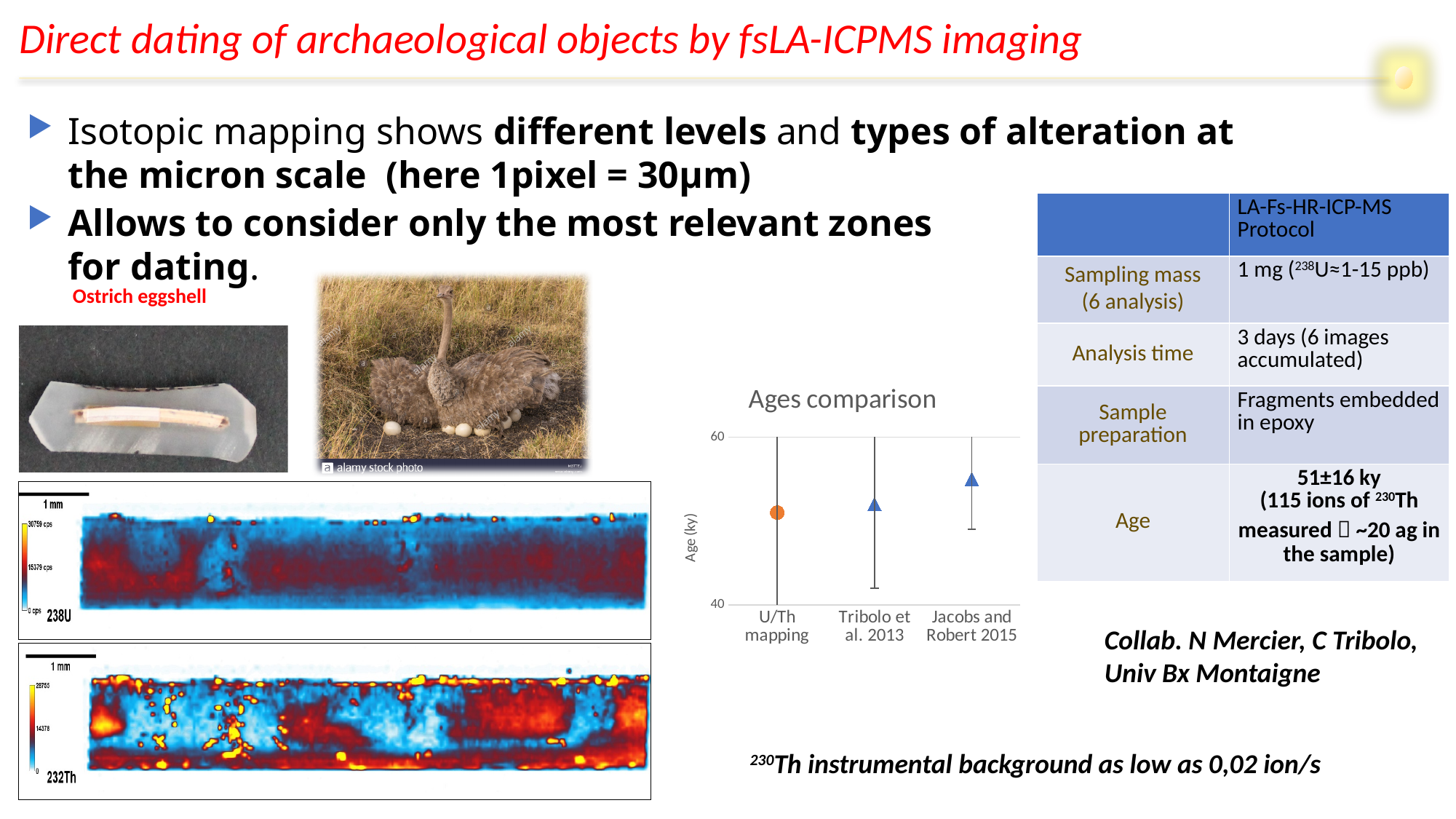
In the Ages comparison chart, which category has the highest plotted age? Jacobs and Robert 2015 In the Ages comparison chart, which is larger: the plotted age for Jacobs and Robert 2015 or for U/Th mapping? Jacobs and Robert 2015 What is the title of the chart on the slide? Ages comparison In the Ages comparison chart, is the plotted age for Jacobs and Robert 2015 greater or less than 50? greater In the Ages comparison chart, do the plotted ages rise or fall from U/Th mapping to Jacobs and Robert 2015? rise In the Ages comparison chart, is the plotted age for Tribolo et al. 2013 greater or less than 60? less In the Ages comparison chart, what is the lowest value shown on the vertical axis? 40 What kind of chart is the Ages comparison chart? Scatter (point) chart with error bars In the Ages comparison chart, what is the label of the vertical axis? Age (ky) How many categories are shown on the x axis of the Ages comparison chart? 3 In the Ages comparison chart, is the plotted age for U/Th mapping greater or less than 40? greater